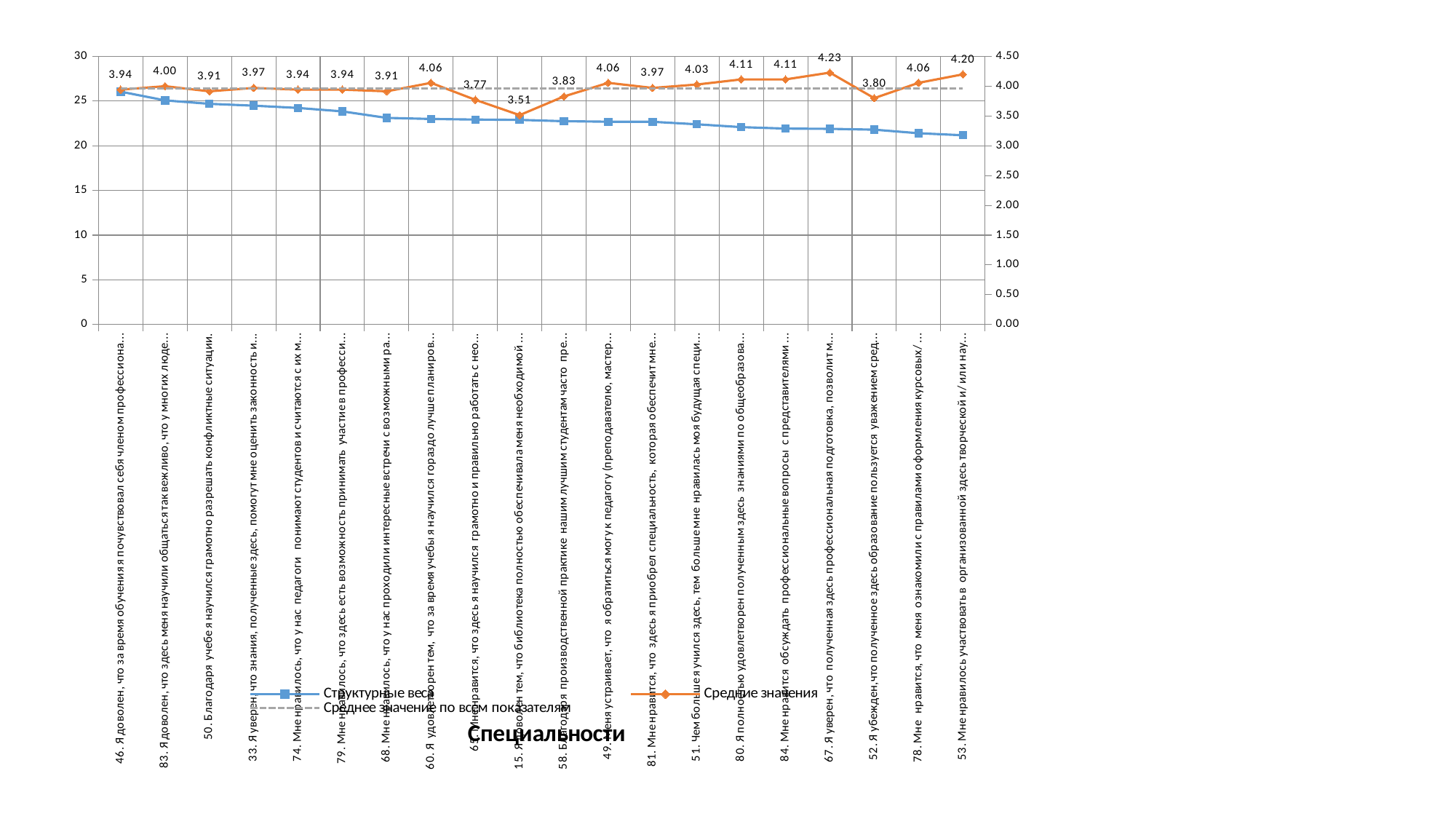
What is the value of the 'Средние значения' series for the category beginning '52. Я убежден, что полученное здесь образование...'? 3.80 Does the 'Структурные веса' series generally rise or fall from left to right along the x axis? fall How many categories are plotted along the x axis? 20 In the 'Средние значения' series, which is larger: the value for the category beginning '53. Мне нравилось участвовать...' or the category beginning '78. Мне нравится, что меня ознакомили...'? 53. Мне нравилось участвовать... What is the value of the 'Средние значения' series for the category beginning '67. Я уверен, что полученная здесь профессиональная подготовка...'? 4.23 Which category has the lowest value in the 'Средние значения' series? 15. Я доволен тем, что библиотека... Which category has the highest value in the 'Средние значения' series? 67. Я уверен, что полученная здесь профессиональная подготовка... Is the 'Структурные веса' value for the category beginning '53. Мне нравилось участвовать...' greater or less than 25 on the left axis? less What is the value of the 'Средние значения' series for the category beginning '15. Я доволен тем, что библиотека...'? 3.51 What kind of chart is shown on the slide? line chart How many series does the legend list? 3 What is the difference between the highest (4.23) and lowest (3.51) values of the 'Средние значения' series? 0.72